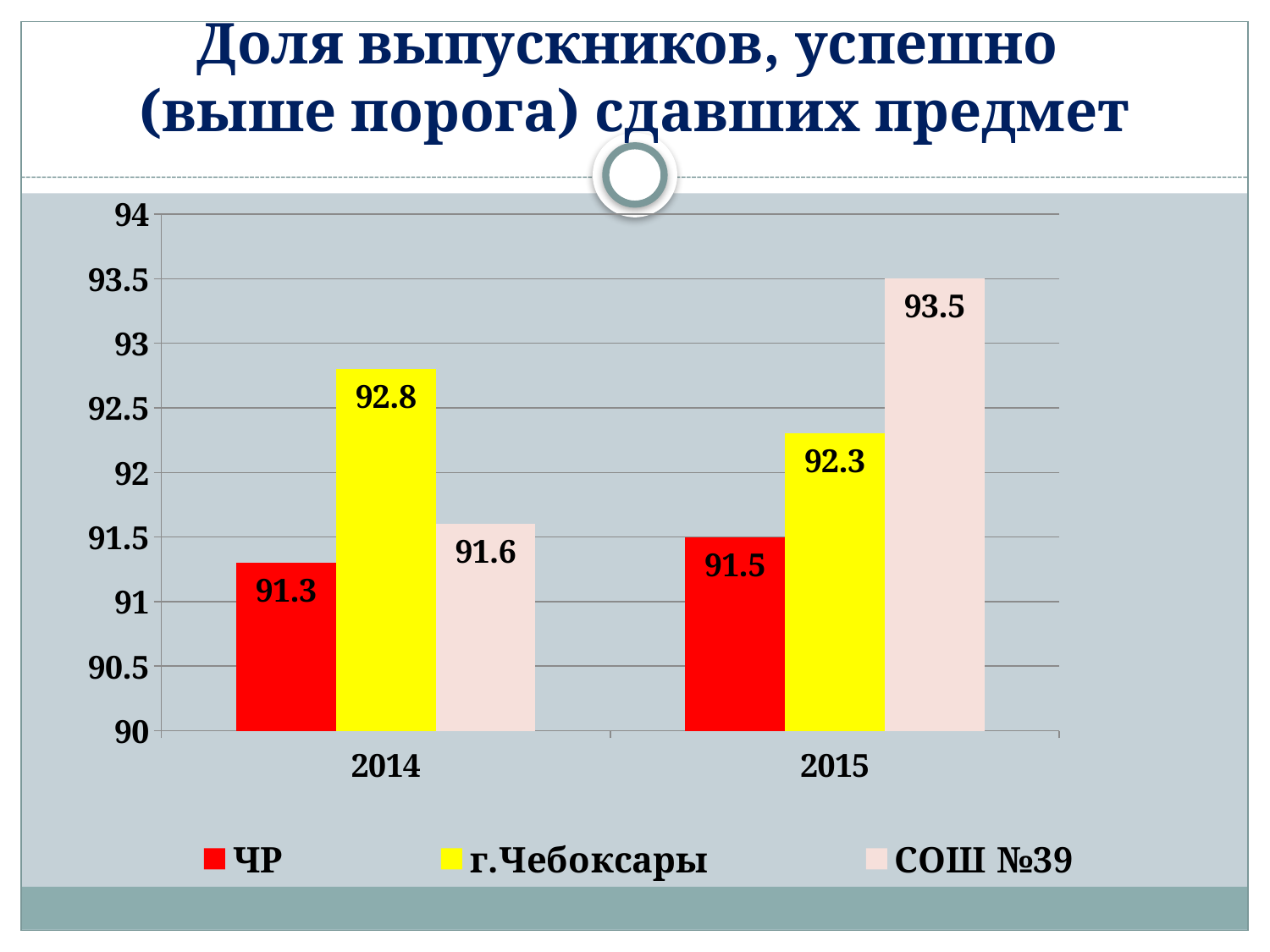
How many year categories are shown on the x axis? 2 Does the value for г.Чебоксары rise or fall from 2014 to 2015? Fall What is the difference between г.Чебоксары and ЧР in 2014? 1.5 How many series does the legend list? 3 Which is larger in 2014: г.Чебоксары or СОШ №39? г.Чебоксары What is the value for ЧР in 2014? 91.3 What is the difference between the СОШ №39 values for 2015 and 2014? 1.9 Which series has the lowest value in 2014? ЧР What is the value for СОШ №39 in 2015? 93.5 What is the value for г.Чебоксары in 2015? 92.3 Which series has the highest value in 2015? СОШ №39 What kind of chart is shown on the slide? Bar chart